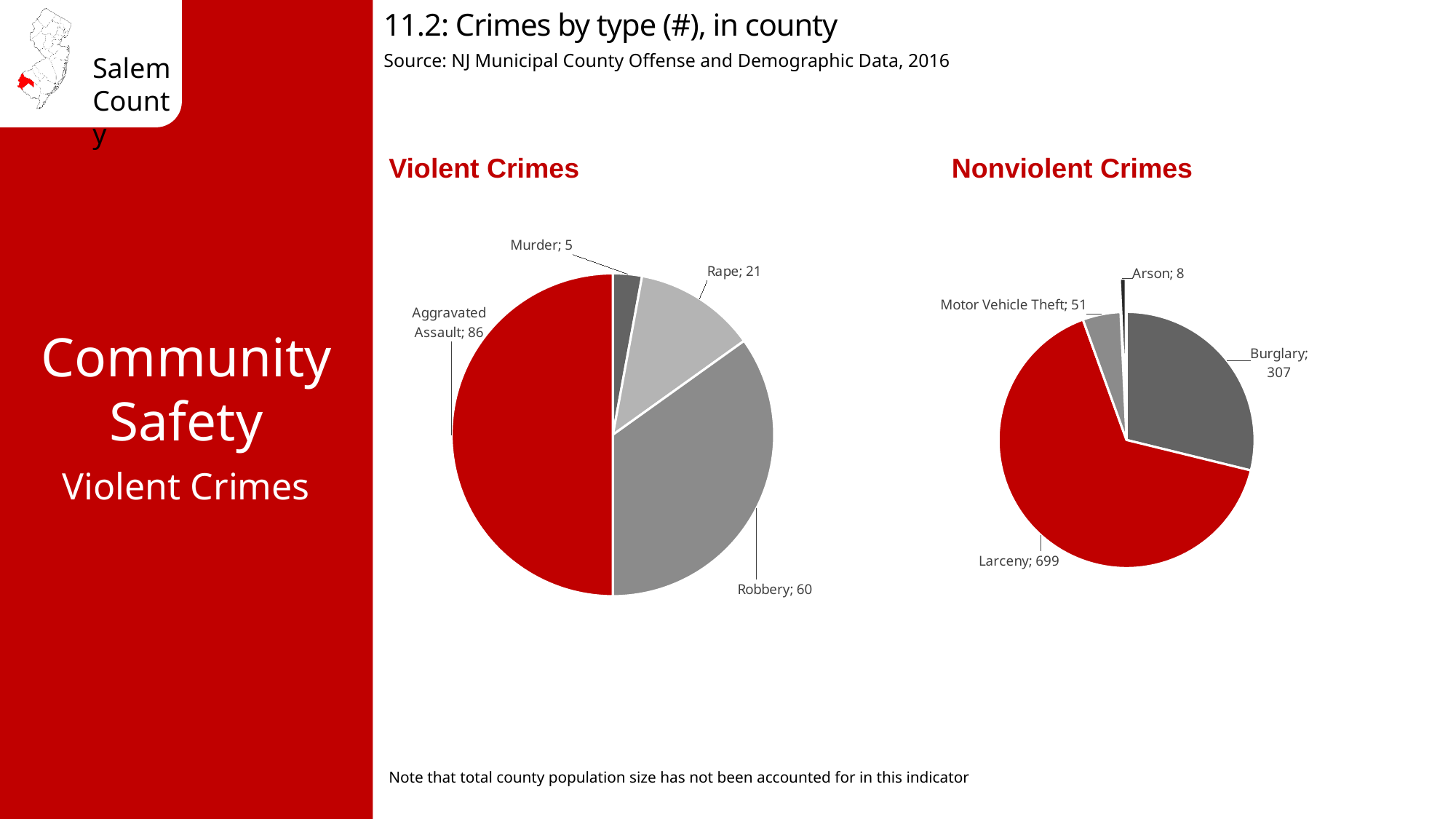
In the Violent Crimes chart, how many robberies are shown? 60 In the Nonviolent Crimes chart, which crime type has the smallest slice? Arson In the Violent Crimes chart, which crime type has the largest slice? Aggravated Assault What kind of chart is the Violent Crimes chart? Pie chart In the Nonviolent Crimes chart, what is the value for Burglary? 307 In the Violent Crimes chart, what is the difference between Aggravated Assault and Robbery? 26 How many crime types are shown in the Nonviolent Crimes chart? 4 In the Nonviolent Crimes chart, what is the difference between Larceny and Burglary? 392 In the Violent Crimes chart, what share of the total does Aggravated Assault represent? 50% What is the source cited for the charts on this slide? NJ Municipal County Offense and Demographic Data, 2016 In the Violent Crimes chart, what is the total number of crimes across all slices? 172 In the Violent Crimes chart, which is larger, Rape or Murder? Rape